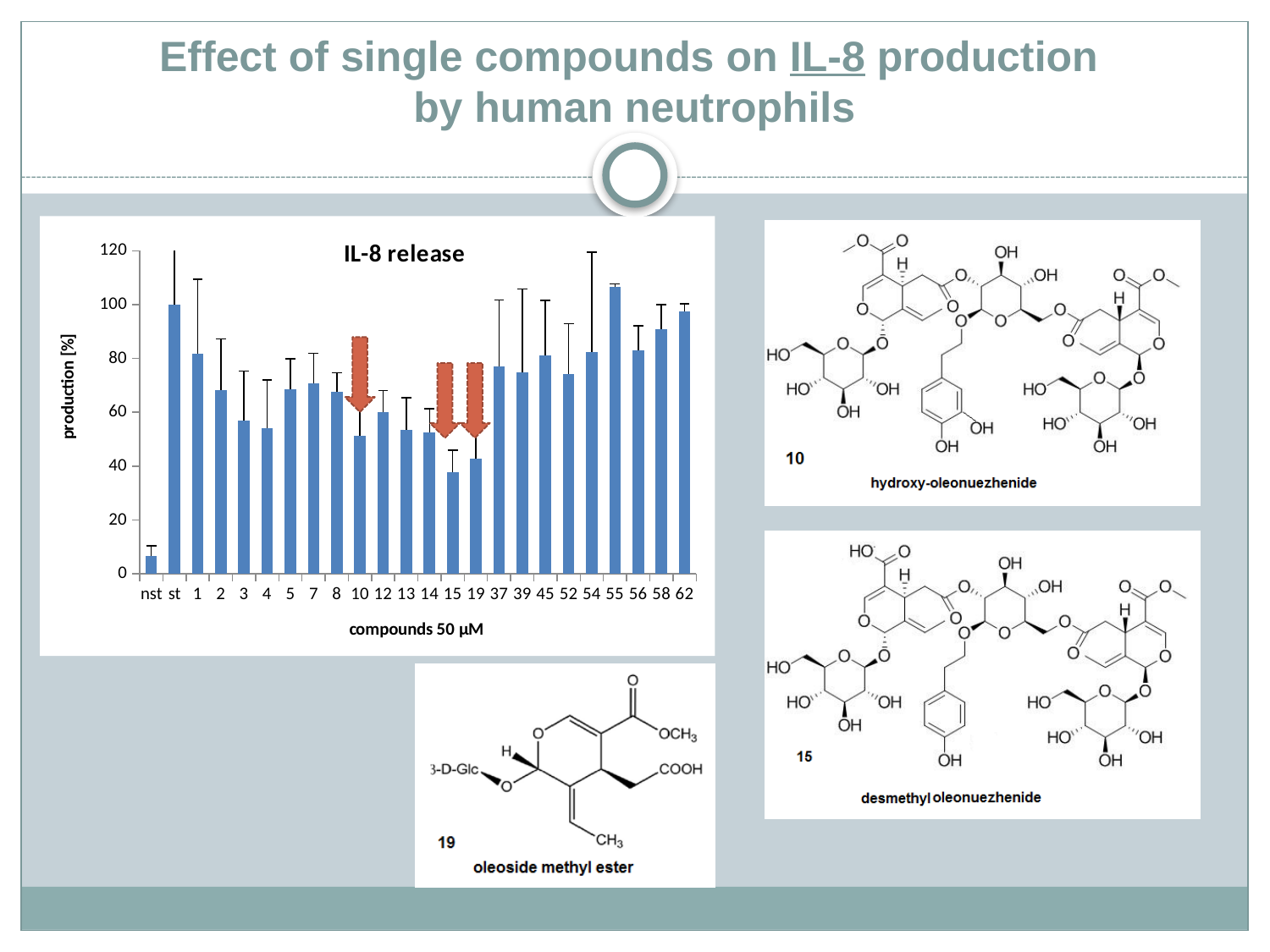
Is the value for compound 15 greater or less than 60? less Which category has the lowest bar in the chart? nst Is the value for compound 10 greater or less than 60? less What is the label of the y axis of the chart? production [%] Is the value for compound 62 greater or less than 80? greater Which category has the highest bar in the chart? 55 What kind of chart is shown on the slide? bar chart How many categories are shown on the x axis of the chart? 24 Which has the larger value, compound 15 or compound 55? 55 What is the title of the chart? IL-8 release